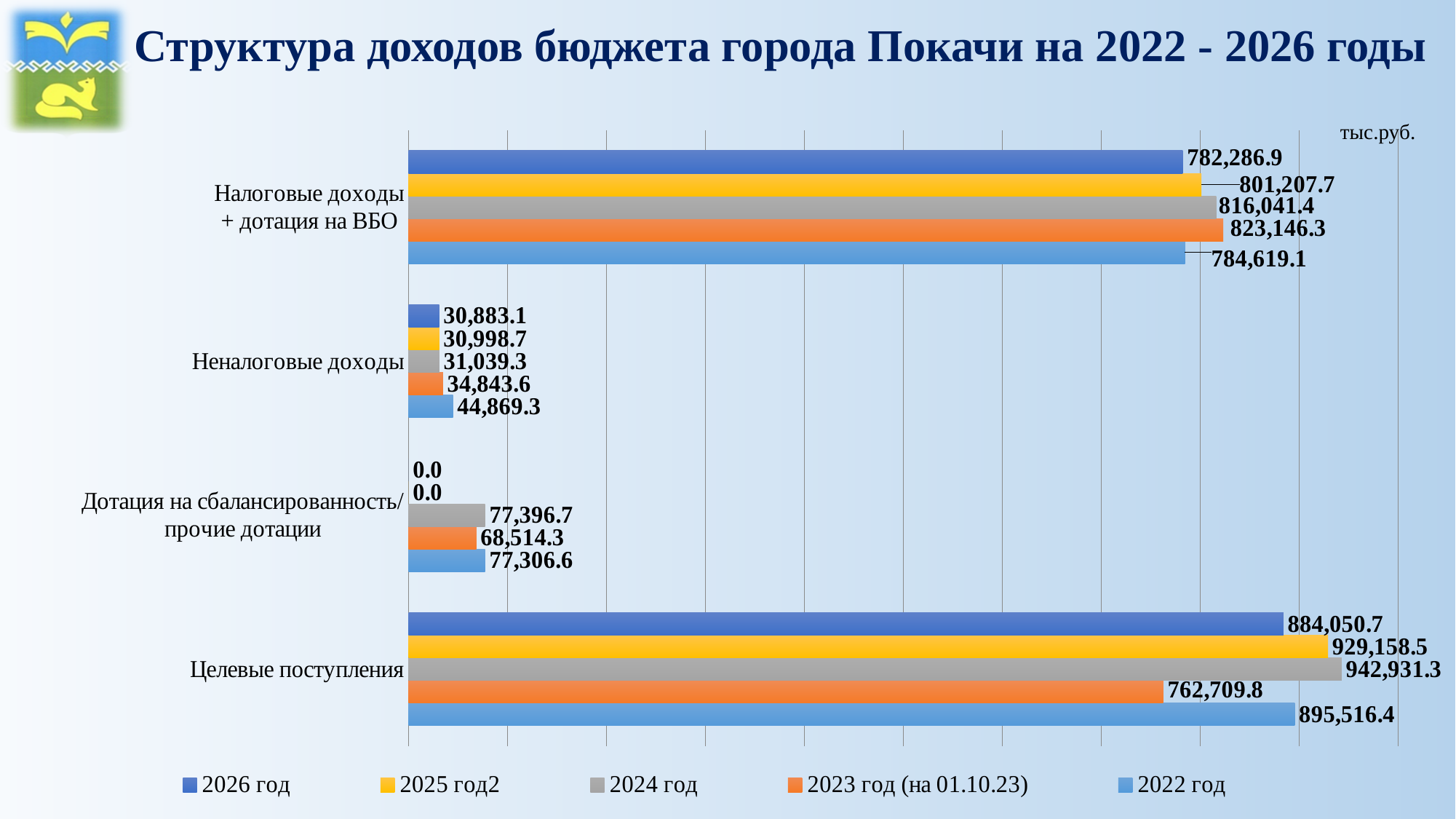
Which is larger for Налоговые доходы + дотация на ВБО: the 2023 год (на 01.10.23) value or the 2026 год value? 2023 год (на 01.10.23) How many categories are shown on the chart? 4 What unit is indicated in the top right corner of the chart? тыс.руб. What type of chart is shown on the slide? bar chart Which series has the lowest value for Неналоговые доходы? 2026 год What is the value for Целевые поступления in the 2024 год series? 942,931.3 What is the value for Налоговые доходы + дотация на ВБО in the 2026 год series? 782,286.9 How many series does the legend list? 5 What is the difference between the 2024 год and 2023 год (на 01.10.23) values for Целевые поступления? 180,221.5 What is the value for Дотация на сбалансированность/прочие дотации in the 2023 год (на 01.10.23) series? 68,514.3 What is the value for Неналоговые доходы in the 2022 год series? 44,869.3 Which series has the highest value for Целевые поступления? 2024 год